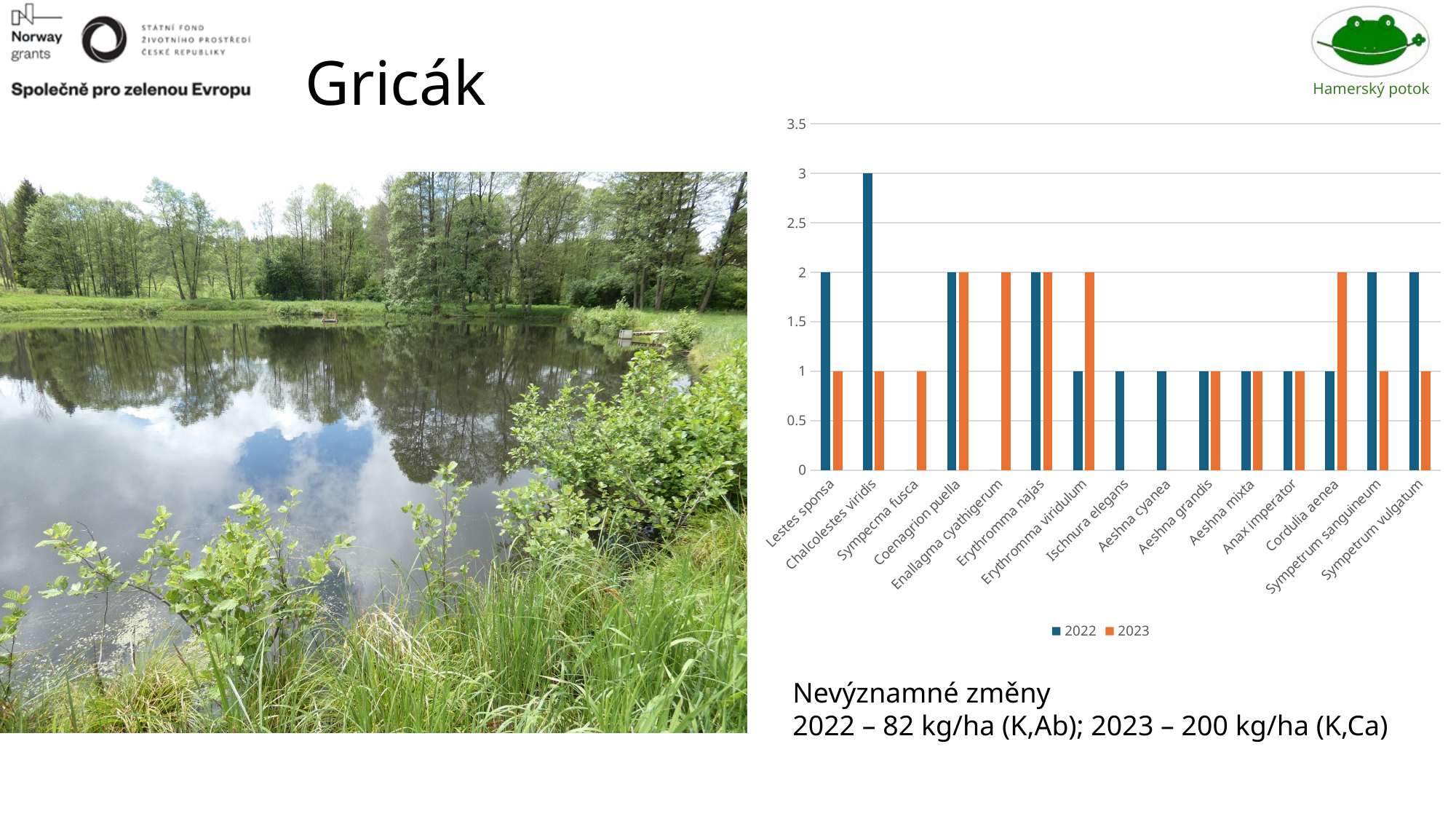
Which species has the highest value for 2022 in the chart? Chalcolestes viridis What is the difference between the 2022 and 2023 values for Chalcolestes viridis? 2 For Sympetrum vulgatum, which year has the larger value, 2022 or 2023? 2022 What is the 2022 value for Lestes sponsa? 2 How many series does the chart legend list? 2 What is the 2022 value for Chalcolestes viridis? 3 For Cordulia aenea, which year has the larger value, 2022 or 2023? 2023 What is the 2023 value for Enallagma cyathigerum? 2 Which colour represents the 2023 series in the chart? orange Is the 2022 value for Chalcolestes viridis greater or less than 2.5? greater What type of chart is shown on the slide? bar chart How many species categories are shown on the x axis of the chart? 15